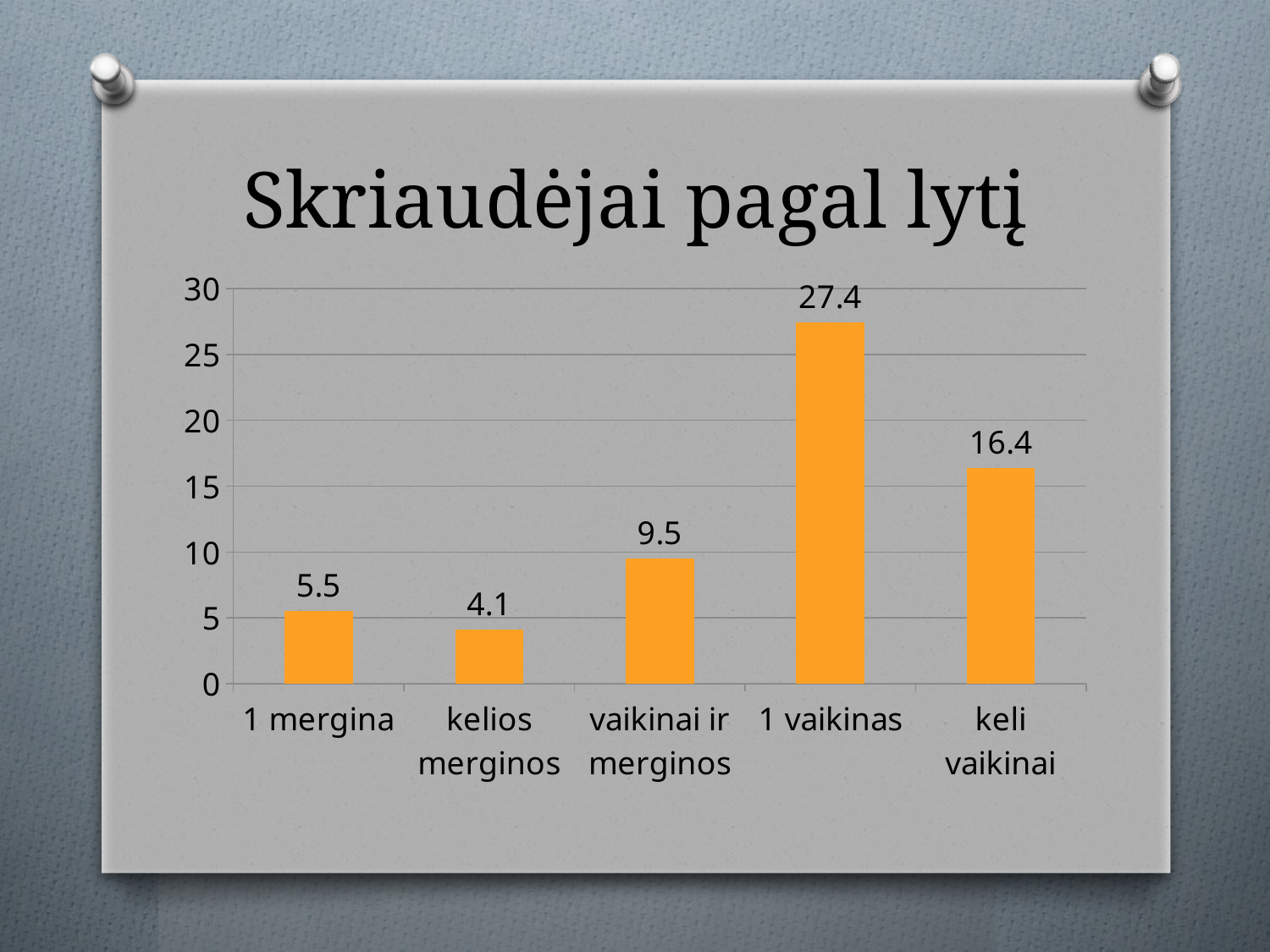
Which category has the highest value? 1 vaikinas How many categories are shown on the x axis? 5 What is the value for "kelios merginos"? 4.1 What kind of chart is shown on the slide? bar chart What is the value for "1 vaikinas"? 27.4 What is the difference between the values for "1 vaikinas" and "keli vaikinai"? 11 What is the value for "keli vaikinai"? 16.4 Is the value for "keli vaikinai" greater or less than 15? greater Which category has the lowest value? kelios merginos What is the title of the chart? Skriaudėjai pagal lytį What is the value for "vaikinai ir merginos"? 9.5 Which is larger, the value for "1 mergina" or the value for "kelios merginos"? 1 mergina